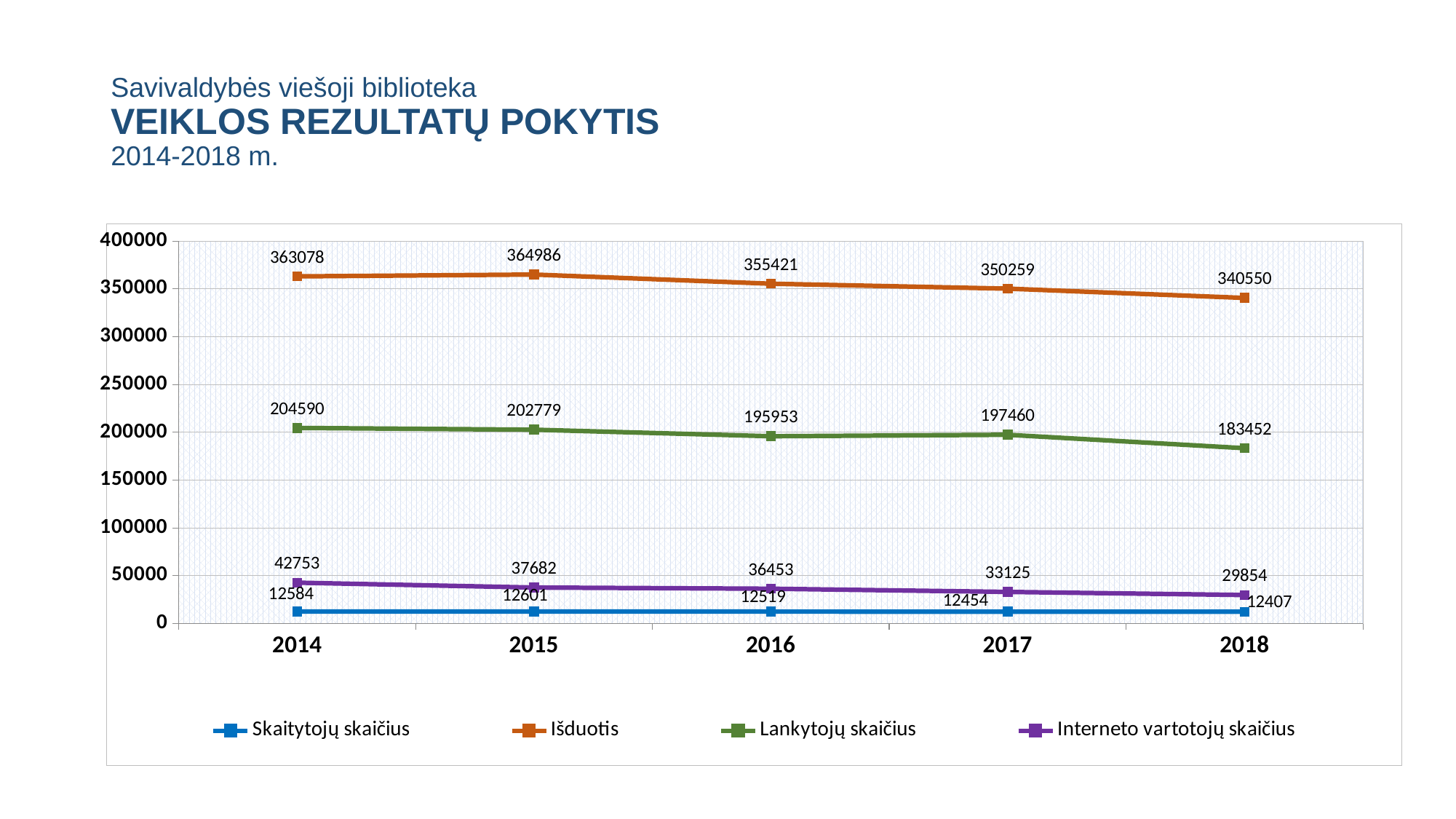
How many years are shown on the x axis? 5 What kind of chart is shown on the slide? line chart Does Interneto vartotojų skaičius rise or fall from 2014 to 2018? fall What is the value of Skaitytojų skaičius in 2017? 12454 What is the value of Išduotis in 2016? 355421 How many series does the legend list? 4 What is the difference between Išduotis in 2014 and in 2018? 22528 What is the value of Interneto vartotojų skaičius in 2014? 42753 Which is larger: Lankytojų skaičius in 2016 or in 2017? 2017 In which year is Lankytojų skaičius lowest? 2018 What is the value of Lankytojų skaičius in 2018? 183452 In which year is Išduotis highest? 2015